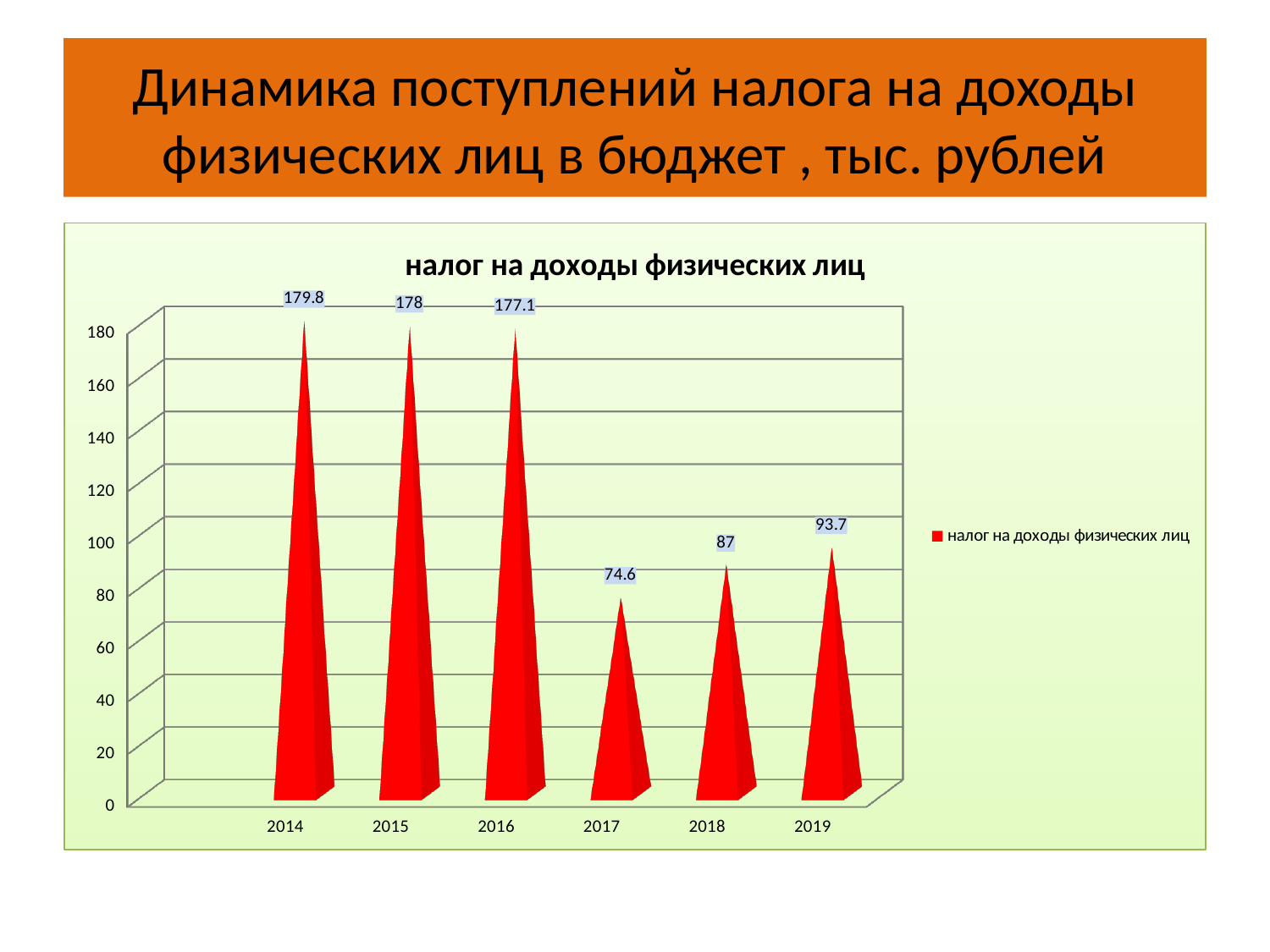
How many years are shown on the x axis? 6 Which is larger, the value for 2018 or the value for 2019? 2019 What is the value for 2014? 179.8 What is the difference between the values for 2019 and 2018? 6.7 Is the value for 2018 greater or less than 100? less Which year has the highest value? 2014 How many series does the legend list? 1 What is the value for 2017? 74.6 What is the difference between the values for 2016 and 2017? 102.5 What is the title of the chart? налог на доходы физических лиц What is the value for 2019? 93.7 Which year has the lowest value? 2017